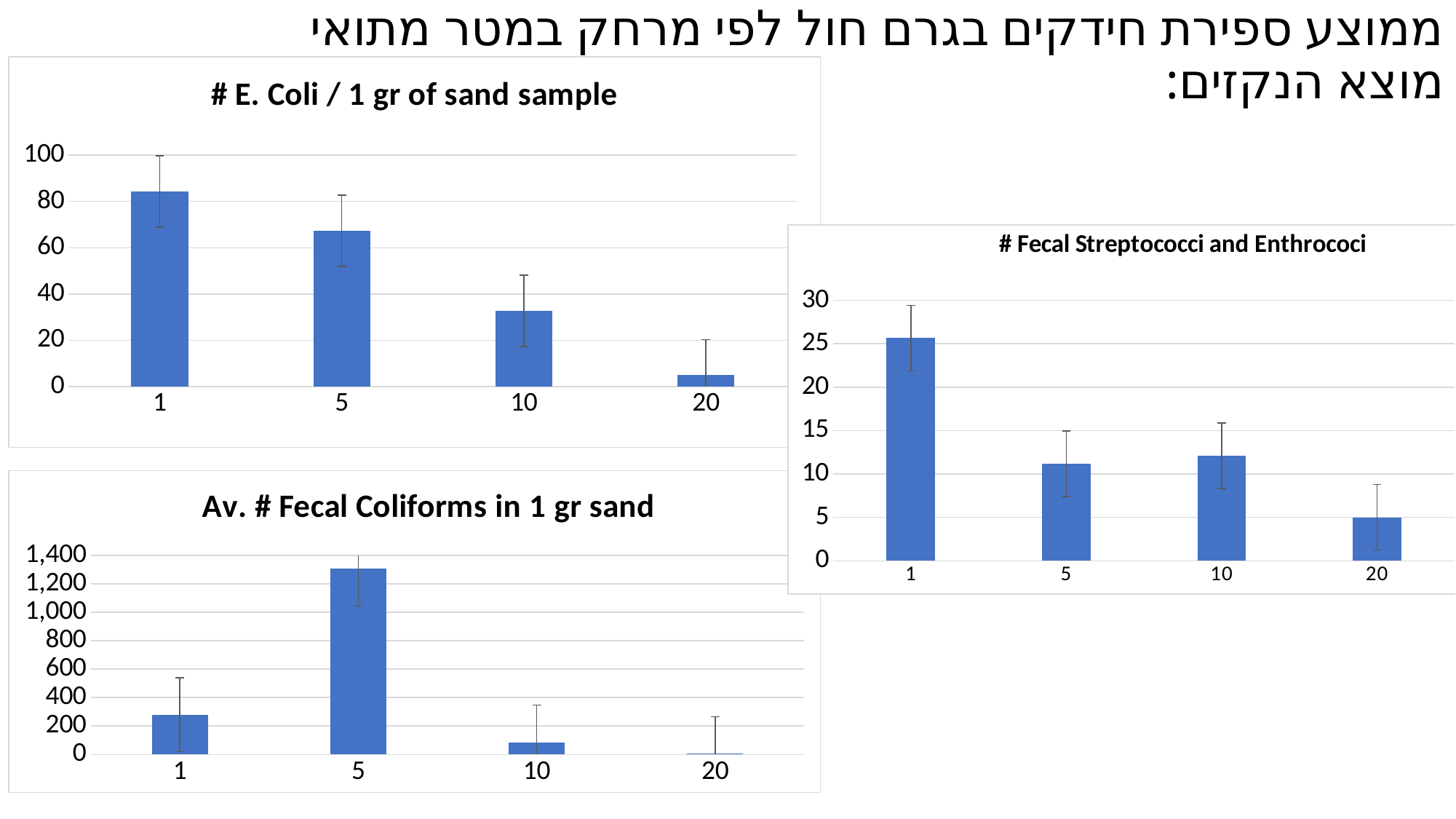
In the 'Av. # Fecal Coliforms in 1 gr sand' chart, which category has the highest value? 5 In the 'Av. # Fecal Coliforms in 1 gr sand' chart, which is larger, the value for category 1 or the value for category 10? 1 In the '# E. Coli / 1 gr of sand sample' chart, is the value for category 1 greater or less than 80? greater In the '# Fecal Streptococci and Enthrococi' chart, is the value for category 1 greater or less than 20? greater How many categories are shown on the x axis of the '# Fecal Streptococci and Enthrococi' chart? 4 What kind of chart is the 'Av. # Fecal Coliforms in 1 gr sand' chart? bar chart In the '# E. Coli / 1 gr of sand sample' chart, is the value for category 10 greater or less than 40? less In the '# E. Coli / 1 gr of sand sample' chart, do the values rise or fall as you move from category 1 to category 20? fall In the '# E. Coli / 1 gr of sand sample' chart, which category has the highest value? 1 In the '# E. Coli / 1 gr of sand sample' chart, which category has the lowest value? 20 In the '# Fecal Streptococci and Enthrococi' chart, which category has the highest value? 1